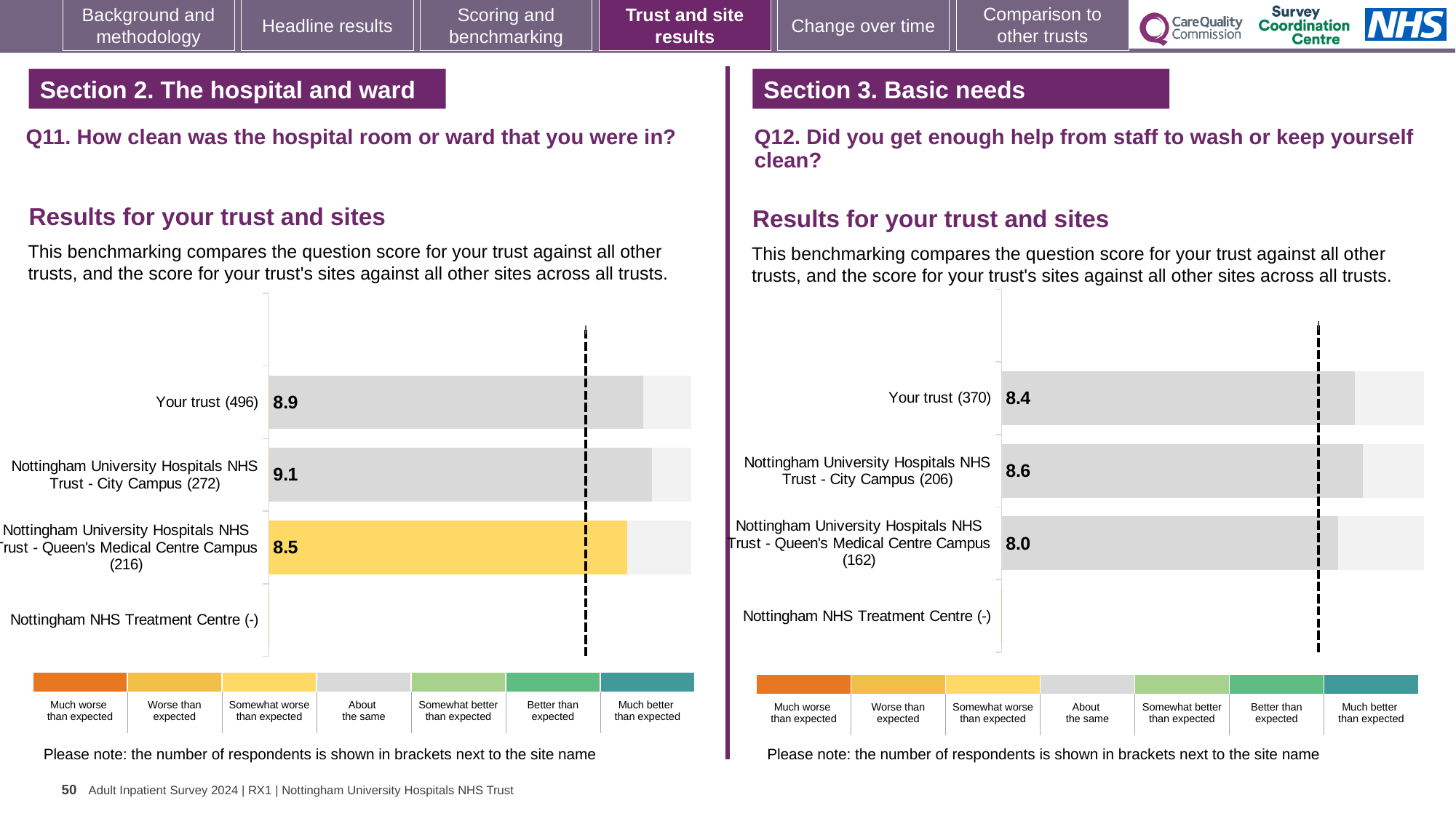
On the Q11 chart (left), what is the score for Nottingham University Hospitals NHS Trust - City Campus (272)? 9.1 On the Q12 chart (right), what is the difference between the City Campus score and the Queen's Medical Centre Campus score? 0.6 On the Q11 chart (left), what is the difference between the City Campus score and the Queen's Medical Centre Campus score? 0.6 On the Q12 chart (right), what is the score for Nottingham University Hospitals NHS Trust - Queen's Medical Centre Campus (162)? 8.0 On the Q12 chart (right), which site or trust has the lowest score? Nottingham University Hospitals NHS Trust - Queen's Medical Centre Campus (162) On the Q11 chart (left), what is the score for Nottingham University Hospitals NHS Trust - Queen's Medical Centre Campus (216)? 8.5 On the Q11 chart (left), which site or trust has the highest score? Nottingham University Hospitals NHS Trust - City Campus (272) On the Q11 chart (left), which bar is coloured yellow rather than grey? Nottingham University Hospitals NHS Trust - Queen's Medical Centre Campus (216) On the Q12 chart (right), is the score for City Campus (206) or Your trust (370) larger? City Campus (206) On the Q12 chart (right), what is the score for Your trust (370)? 8.4 What kind of chart is used on the Q11 chart (left)? Bar chart On the Q11 chart (left), what is the score for Your trust (496)? 8.9